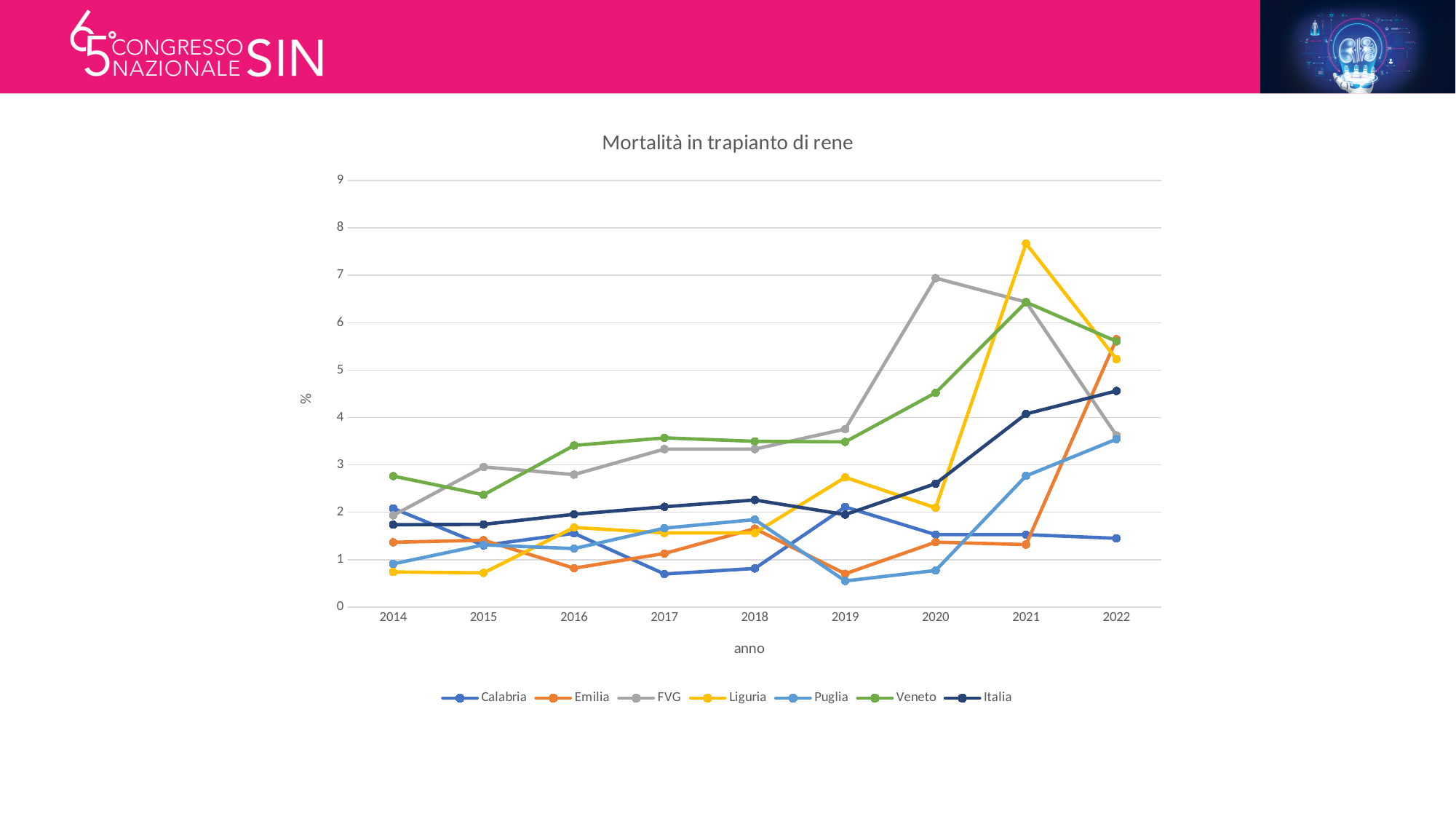
Is the value for Calabria in 2017 greater or less than 1? less What is the label of the x axis? anno Which series has the highest value in 2014? Veneto What kind of chart is shown on the slide? line chart What is the title of the chart? Mortalità in trapianto di rene Is the value for Liguria in 2021 greater or less than 7? greater Which series has the highest value in 2021? Liguria How many series does the legend list? 7 Which series has the highest value in 2020? FVG Which is larger in 2016, Veneto or Calabria? Veneto How many years are shown on the x axis? 9 Does the Italia series rise or fall from 2014 to 2022? rises